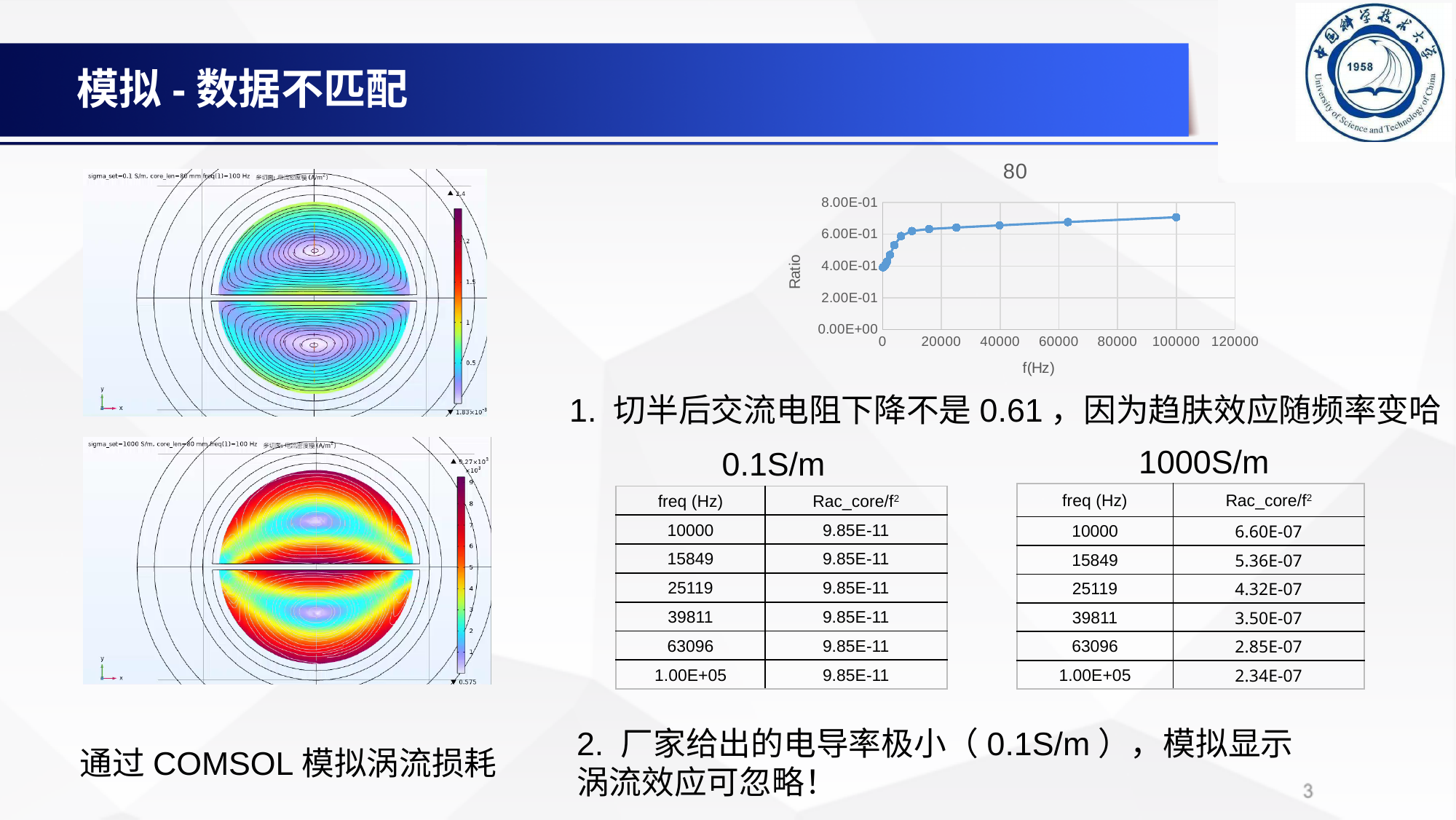
In the chart titled "80", which has the larger Ratio: the point at f = 100000 Hz or the point at the lowest frequency? f = 100000 Hz What kind of chart is the chart titled "80"? line chart In the chart titled "80", is the Ratio at the lowest frequency greater or less than 6.00E-01? less In the chart titled "80", is the Ratio at f = 40000 Hz greater or less than 8.00E-01? less In the chart titled "80", is the Ratio at f = 100000 Hz greater or less than 8.00E-01? less What is the label of the x axis of the chart titled "80"? f(Hz) What is the label of the y axis of the chart titled "80"? Ratio In the chart titled "80", does the Ratio rise or fall as f(Hz) increases? rise